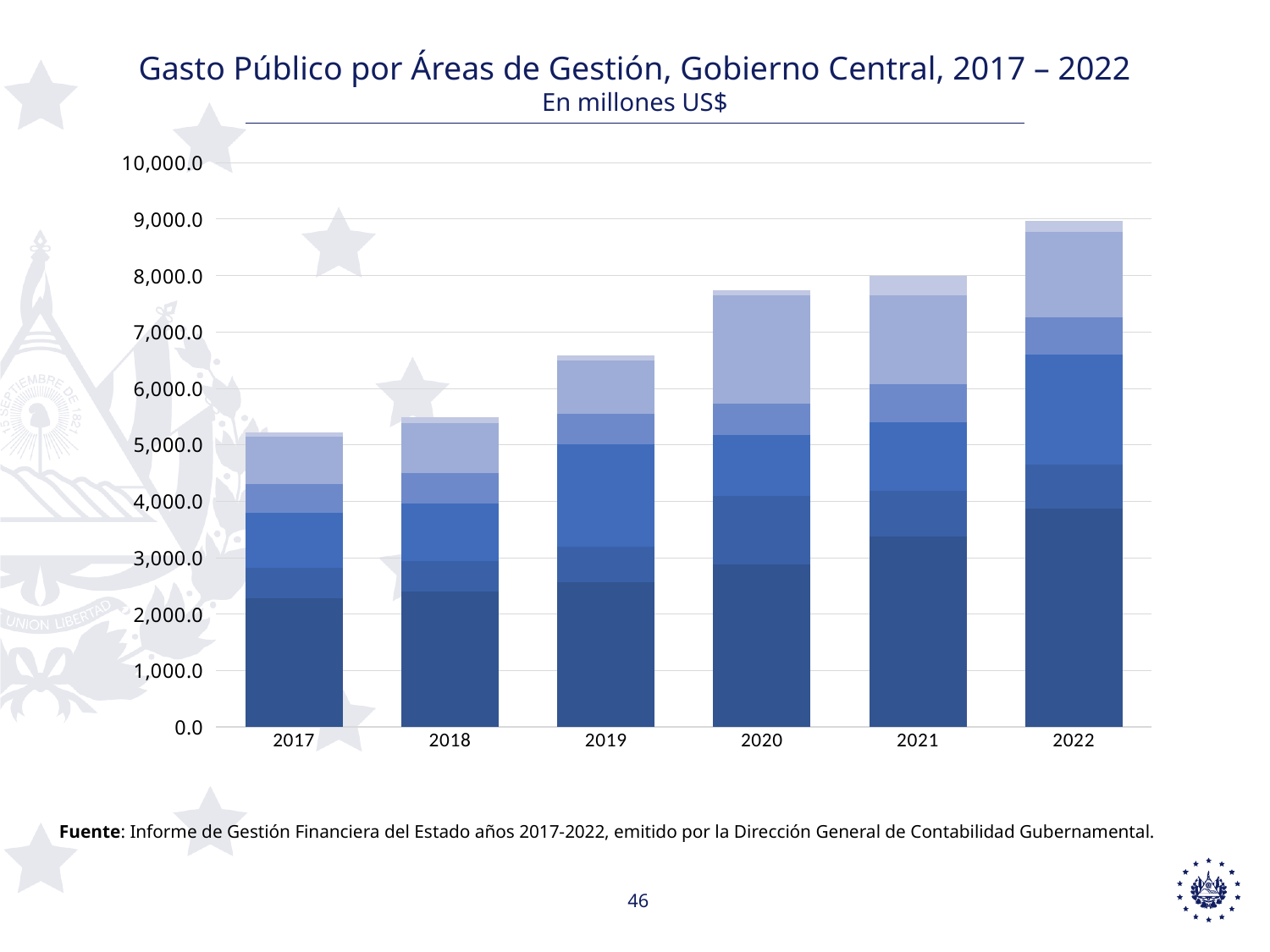
Is the total for 2017 greater or less than 6,000.0? less Is the total for 2018 greater or less than 6,000.0? less What kind of chart is shown on the slide? Stacked bar chart Is the total for 2020 greater or less than 7,000.0? greater In what unit are the values in the chart expressed, according to the subtitle? En millones US$ Which year has a larger total, 2019 or 2021? 2021 Which year has the lowest total public spending in the chart? 2017 Do the total bar heights rise or fall from 2017 to 2022? rise Which year has the highest total public spending in the chart? 2022 How many years are shown on the x axis of the chart? 6